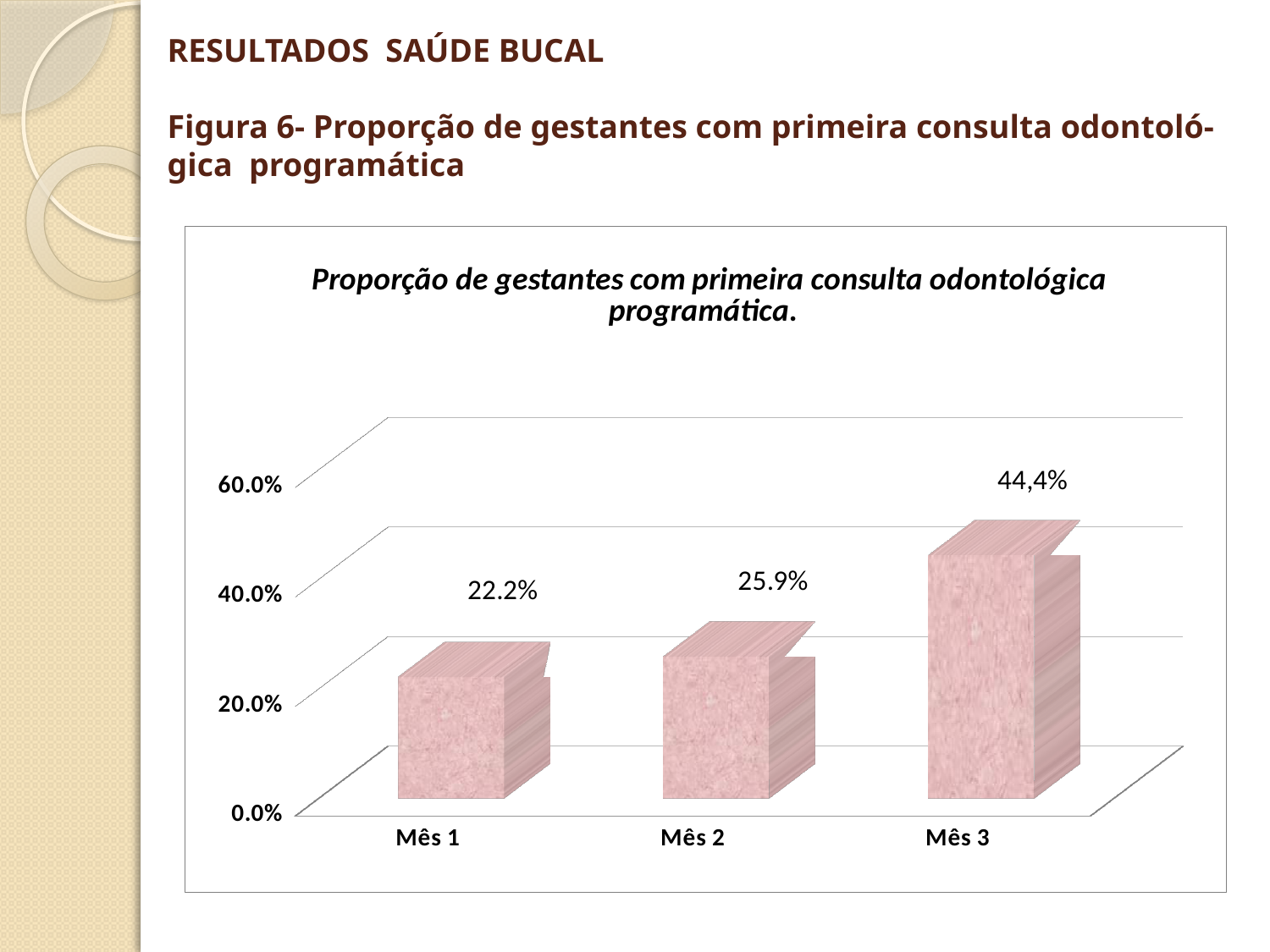
What is the value for Mês 3? 44,4% What is the difference between the values for Mês 2 and Mês 1? 3.7% What kind of chart is shown on the slide? Bar chart Which month has the highest proportion? Mês 3 What is the value for Mês 2? 25.9% How many months are shown on the x axis? 3 Which is larger, the value for Mês 2 or the value for Mês 3? Mês 3 Do the values rise or fall from Mês 1 to Mês 3? Rise What is the difference between the values for Mês 3 and Mês 1? 22.2% Is the value for Mês 1 greater or less than 40.0%? less Which month has the lowest proportion? Mês 1 What is the value for Mês 1? 22.2%